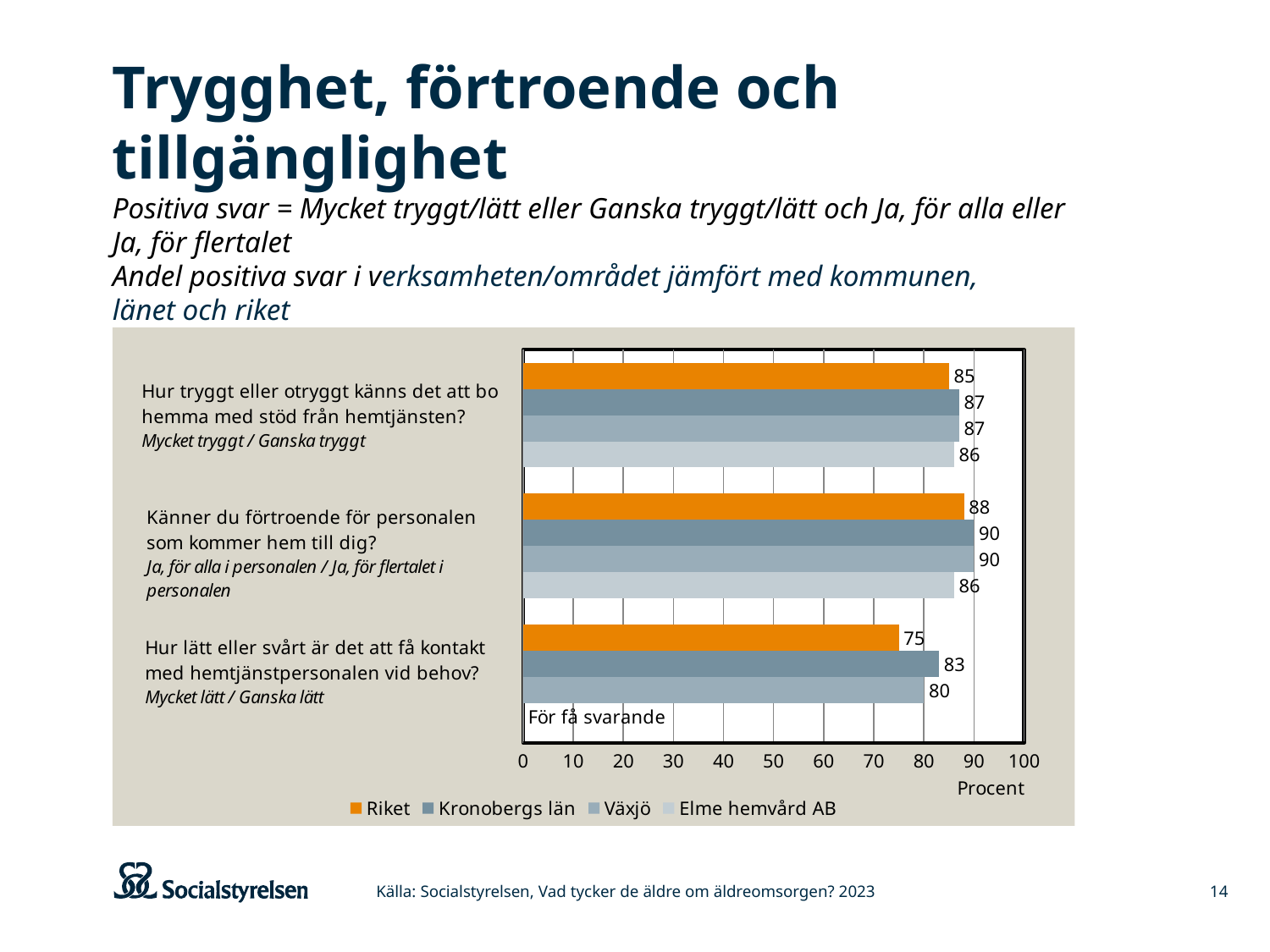
How many question categories are shown on the chart? 3 What is the value for Kronobergs län on the question 'Hur lätt eller svårt är det att få kontakt med hemtjänstpersonalen vid behov?' 83 What is shown for Elme hemvård AB on the question 'Hur lätt eller svårt är det att få kontakt med hemtjänstpersonalen vid behov?' För få svarande Which is larger on the question 'Känner du förtroende för personalen som kommer hem till dig?': Växjö or Elme hemvård AB? Växjö What is the label on the horizontal axis of the chart? Procent What is the difference between Kronobergs län and Riket on the question 'Hur lätt eller svårt är det att få kontakt med hemtjänstpersonalen vid behov?' 8 What is the value for Riket on the question 'Hur tryggt eller otryggt känns det att bo hemma med stöd från hemtjänsten?' 85 Is the value for Riket on the question 'Hur lätt eller svårt är det att få kontakt med hemtjänstpersonalen vid behov?' greater or less than 80? less Which series has the lowest value on the question 'Hur lätt eller svårt är det att få kontakt med hemtjänstpersonalen vid behov?' Riket What kind of chart is shown on the slide? bar chart What is the value for Elme hemvård AB on the question 'Känner du förtroende för personalen som kommer hem till dig?' 86 How many series does the legend list? 4